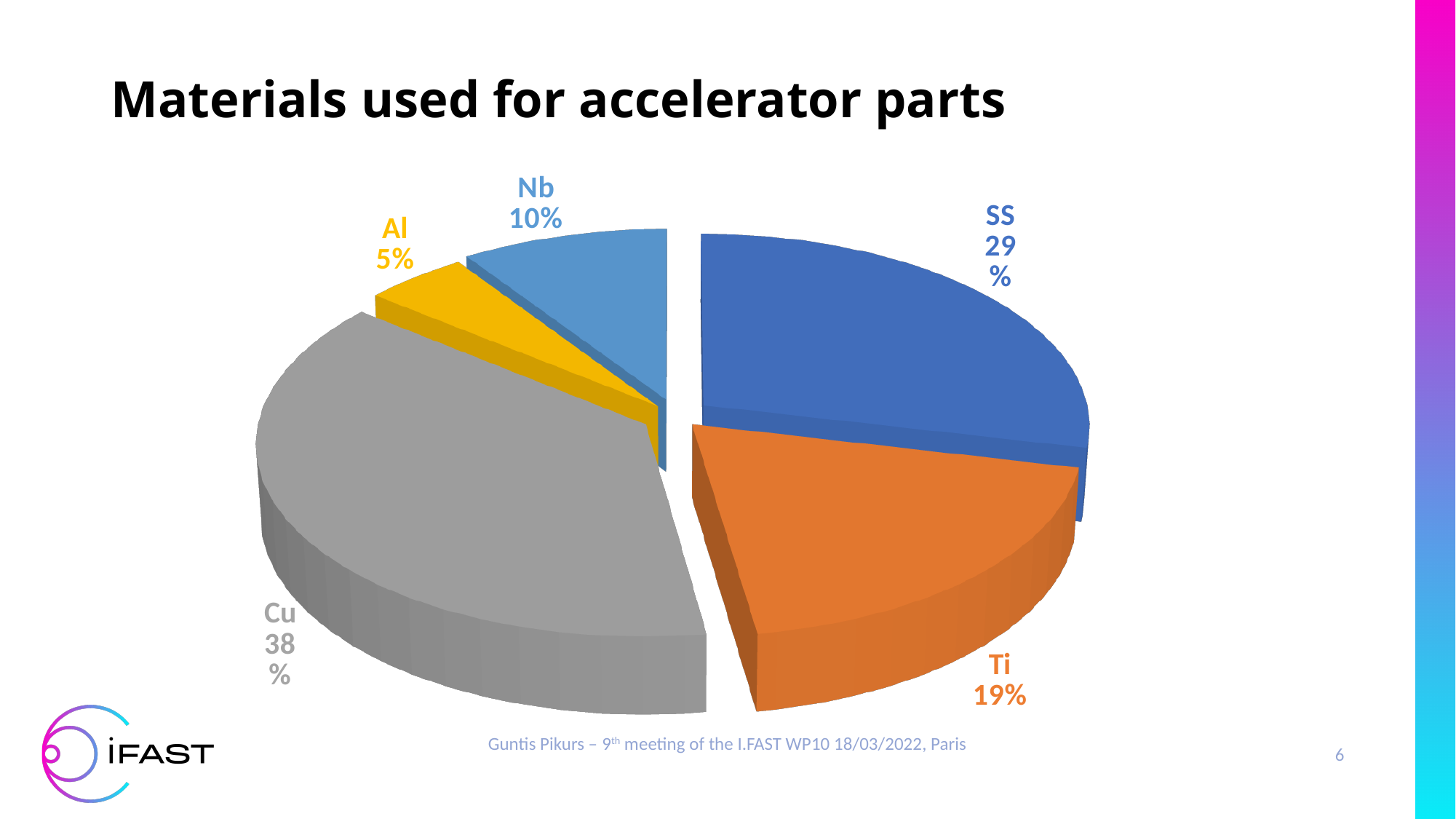
What is the title of the chart on the slide? Materials used for accelerator parts How many materials are shown in the pie chart? 5 What kind of chart is shown on the slide? Pie chart What share of the pie does SS have? 29% What is the difference in percentage points between the Cu share and the SS share? 9 What share of the pie does Nb have? 10% Which material has the smallest share of the pie? Al What share of the pie does Ti have? 19% What share of the pie does Al have? 5% Which material has the largest share of the pie? Cu What share of the pie does Cu have? 38% Which has a larger share, Ti or Nb? Ti